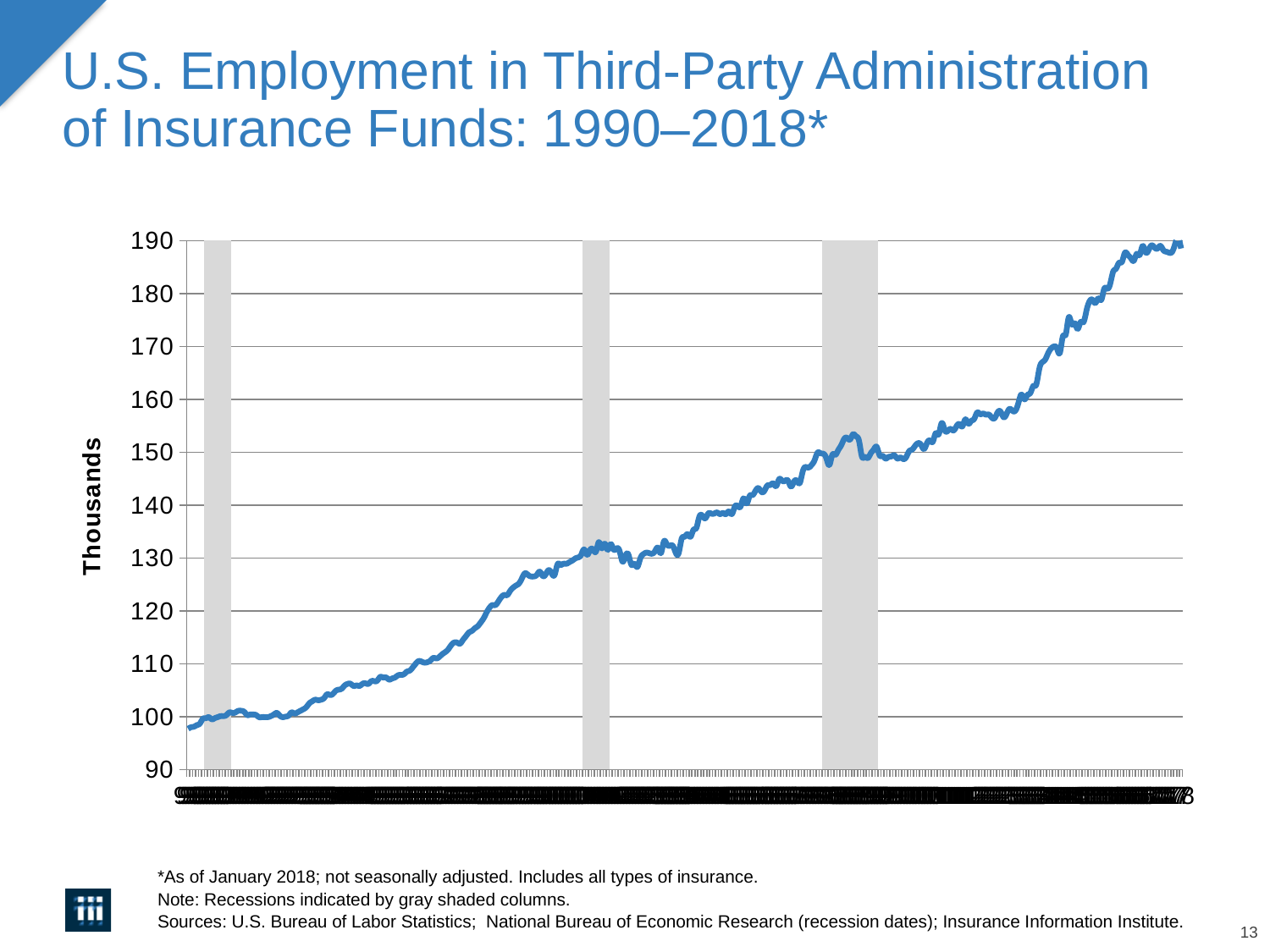
Is the lowest value on the line greater or less than 90? greater Do the values generally rise or fall from left to right along the x axis? rise What kind of chart is shown on the slide? line chart What is the label on the y axis of the chart? Thousands How many gray shaded columns appear on the chart? 3 Is the value at the end of the series greater or less than 180? greater Is the value at the start of the series greater or less than 110? less According to the note, what do the gray shaded columns on the chart indicate? Recessions Which is larger, the value at the start of the series or the value at the end of the series? the end of the series